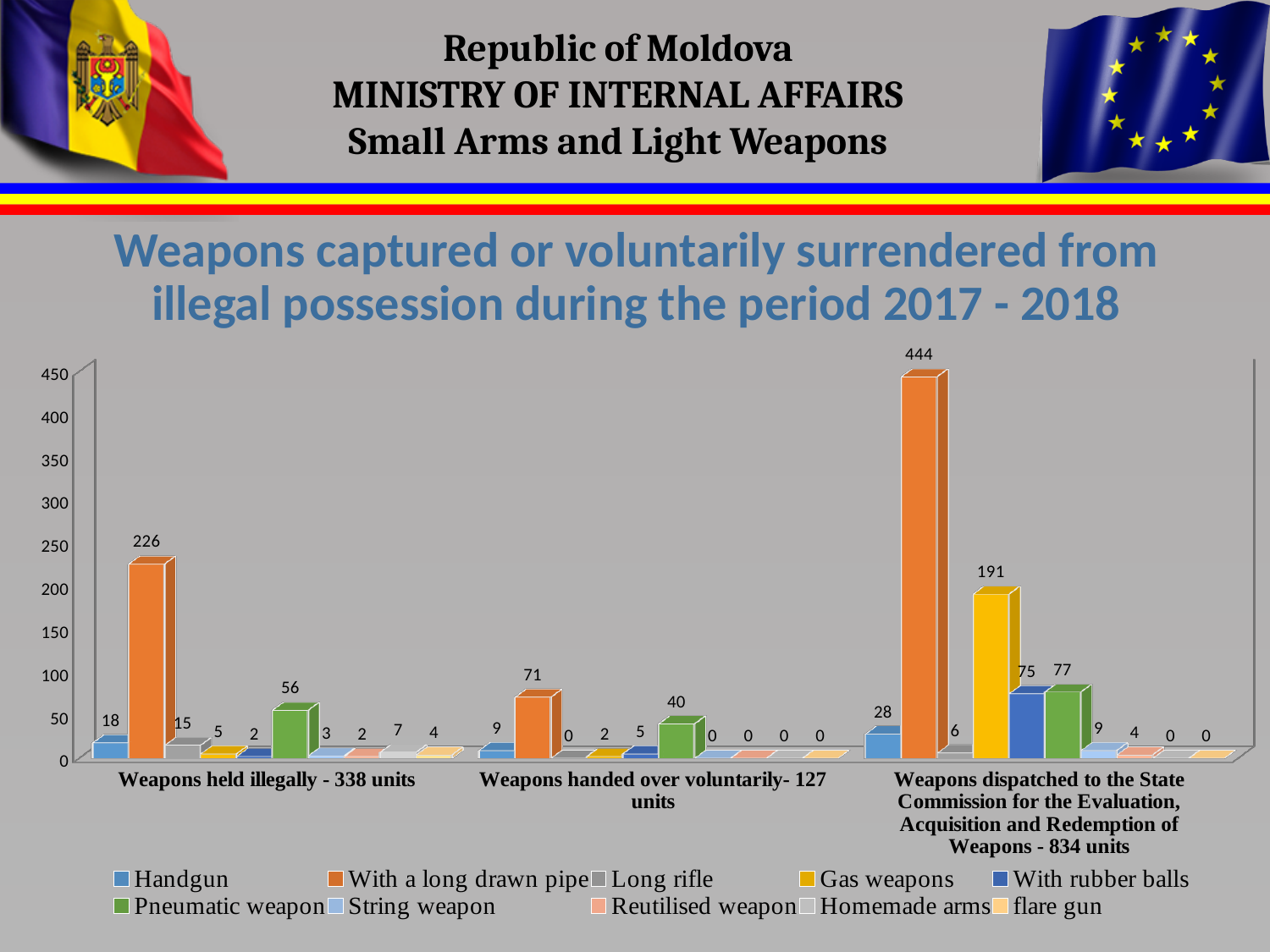
What is the value for 'Handgun' in the 'Weapons handed over voluntarily- 127 units' category? 9 Is the value for 'With a long drawn pipe' in the 'Weapons dispatched to the State Commission' category greater or less than 400? greater Which series has the highest value in the 'Weapons dispatched to the State Commission' category? With a long drawn pipe What is the title of the chart? Weapons captured or voluntarily surrendered from illegal possession during the period 2017 - 2018 What is the difference between the 'With a long drawn pipe' value in the 'Weapons dispatched to the State Commission' category and in the 'Weapons held illegally' category? 218 How many categories are shown on the x axis of the chart? 3 What is the value for 'Pneumatic weapon' in the 'Weapons handed over voluntarily- 127 units' category? 40 What is the value for 'With a long drawn pipe' in the 'Weapons held illegally - 338 units' category? 226 What is the value for 'Gas weapons' in the 'Weapons dispatched to the State Commission for the Evaluation, Acquisition and Redemption of Weapons - 834 units' category? 191 In the 'Weapons held illegally - 338 units' category, which is larger: 'Handgun' or 'Long rifle'? Handgun What kind of chart is shown on the slide? bar chart How many series does the legend list? 10